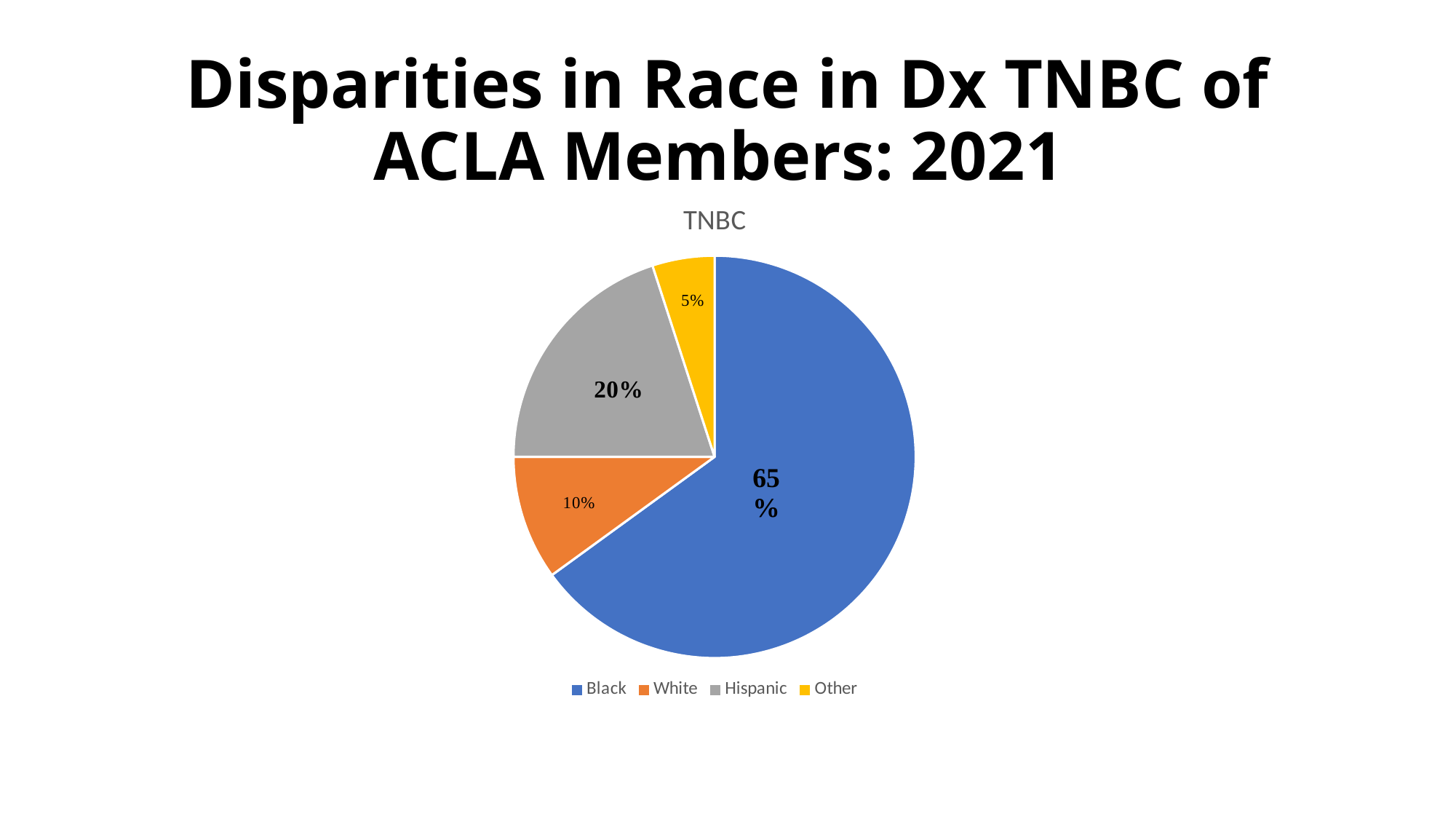
What type of chart is shown on the slide? pie chart What colour is the Other slice? yellow Which is larger, the Hispanic slice or the White slice? Hispanic What percentage of the pie is the Other slice? 5% Which category has the largest share of the pie? Black What is the difference in percentage points between the Black slice and the Hispanic slice? 45 What percentage of the pie is the Hispanic slice? 20% Which category has the smallest share of the pie? Other What percentage of the pie is the Black slice? 65% How many categories does the legend list? 4 What is the chart's title? TNBC What percentage of the pie is the White slice? 10%